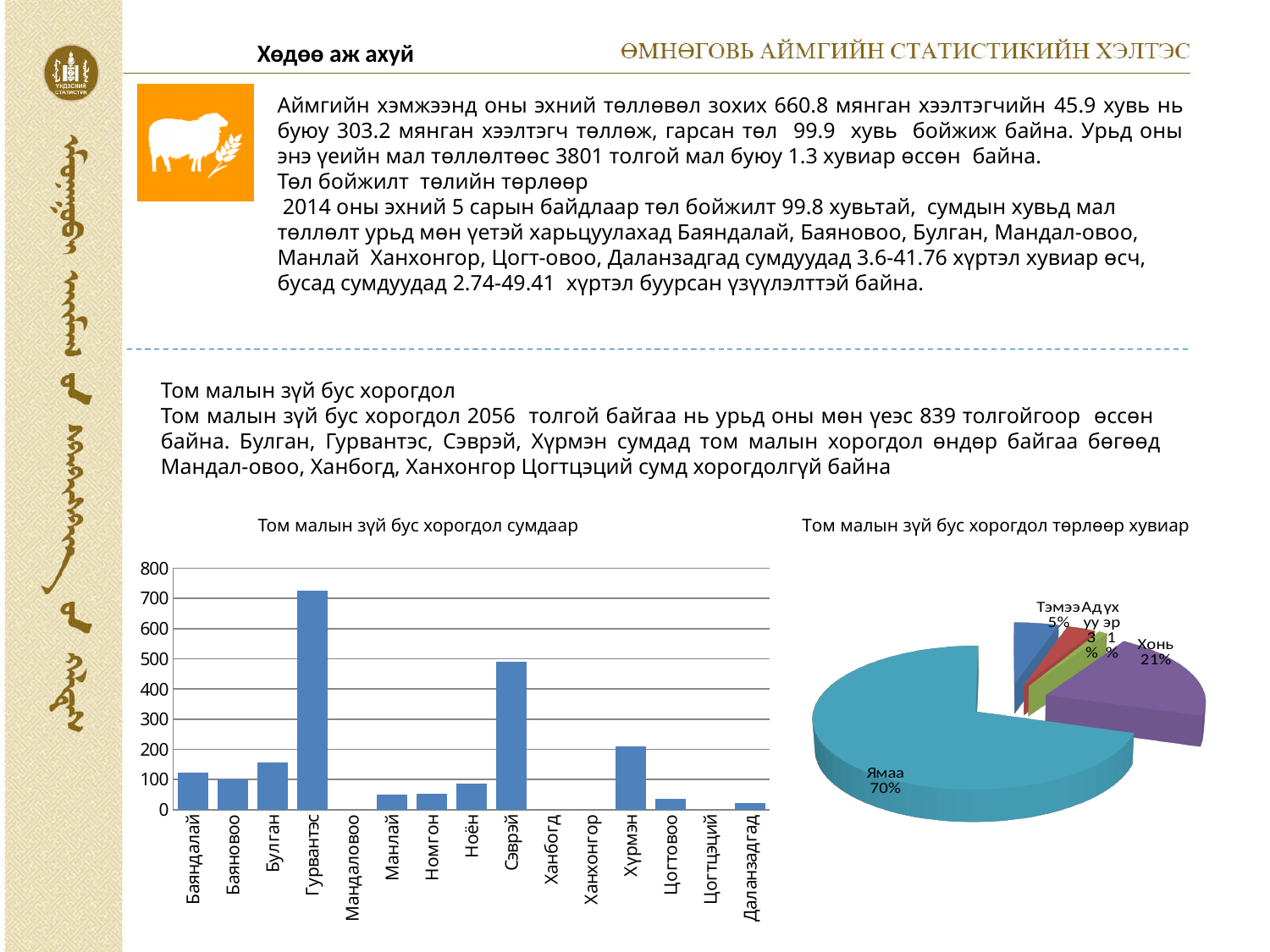
In the chart "Том малын зүй бус хорогдол сумдаар", is the value for Булган greater or less than 100? greater In the pie chart "Том малын зүй бус хорогдол төрлөөр хувиар", what share does Ямаа have? 70% In the chart "Том малын зүй бус хорогдол сумдаар", which sum has the highest value? Гурвантэс In the chart "Том малын зүй бус хорогдол сумдаар", how many sums (categories) are shown on the x axis? 15 In the pie chart "Том малын зүй бус хорогдол төрлөөр хувиар", what share does Хонь have? 21% In the chart "Том малын зүй бус хорогдол сумдаар", which is larger, the value for Сэврэй or the value for Хүрмэн? Сэврэй What kind of chart is "Том малын зүй бус хорогдол төрлөөр хувиар"? pie chart What kind of chart is "Том малын зүй бус хорогдол сумдаар"? bar chart In the pie chart "Том малын зүй бус хорогдол төрлөөр хувиар", which type has the smallest share? Үхэр In the chart "Том малын зүй бус хорогдол сумдаар", is the value for Гурвантэс greater or less than 700? greater In the pie chart "Том малын зүй бус хорогдол төрлөөр хувиар", how many slices are there? 5